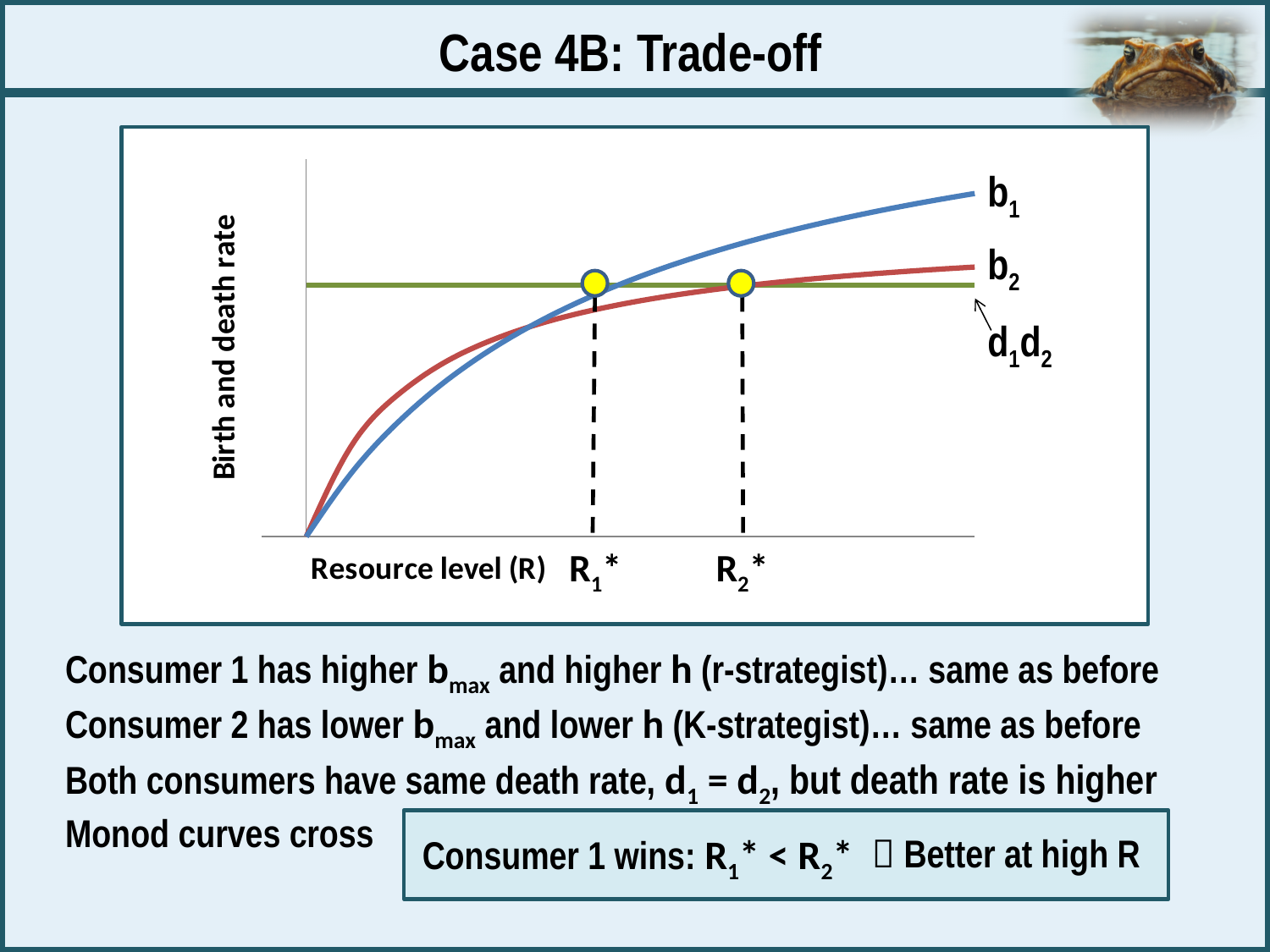
Which curve is higher at low resource levels, b1 or b2? b2 Which curve reaches the highest value at the right end of the chart? b1 Does the b2 curve rise or fall as resource level R increases? Rises What is the label of the y axis of the chart? Birth and death rate What is the label of the x axis of the chart? Resource level (R) Does the b1 curve rise or fall as resource level R increases? Rises At high resource levels, which curve is higher, b1 or b2? b1 How many curves or lines are plotted on the chart? 3 How many yellow marker points are shown on the chart? 2 What kind of chart is shown on the slide? Line chart Does the d1d2 line rise, fall, or stay flat as resource level R increases? Stays flat Which is smaller on the x axis, R1* or R2*? R1*